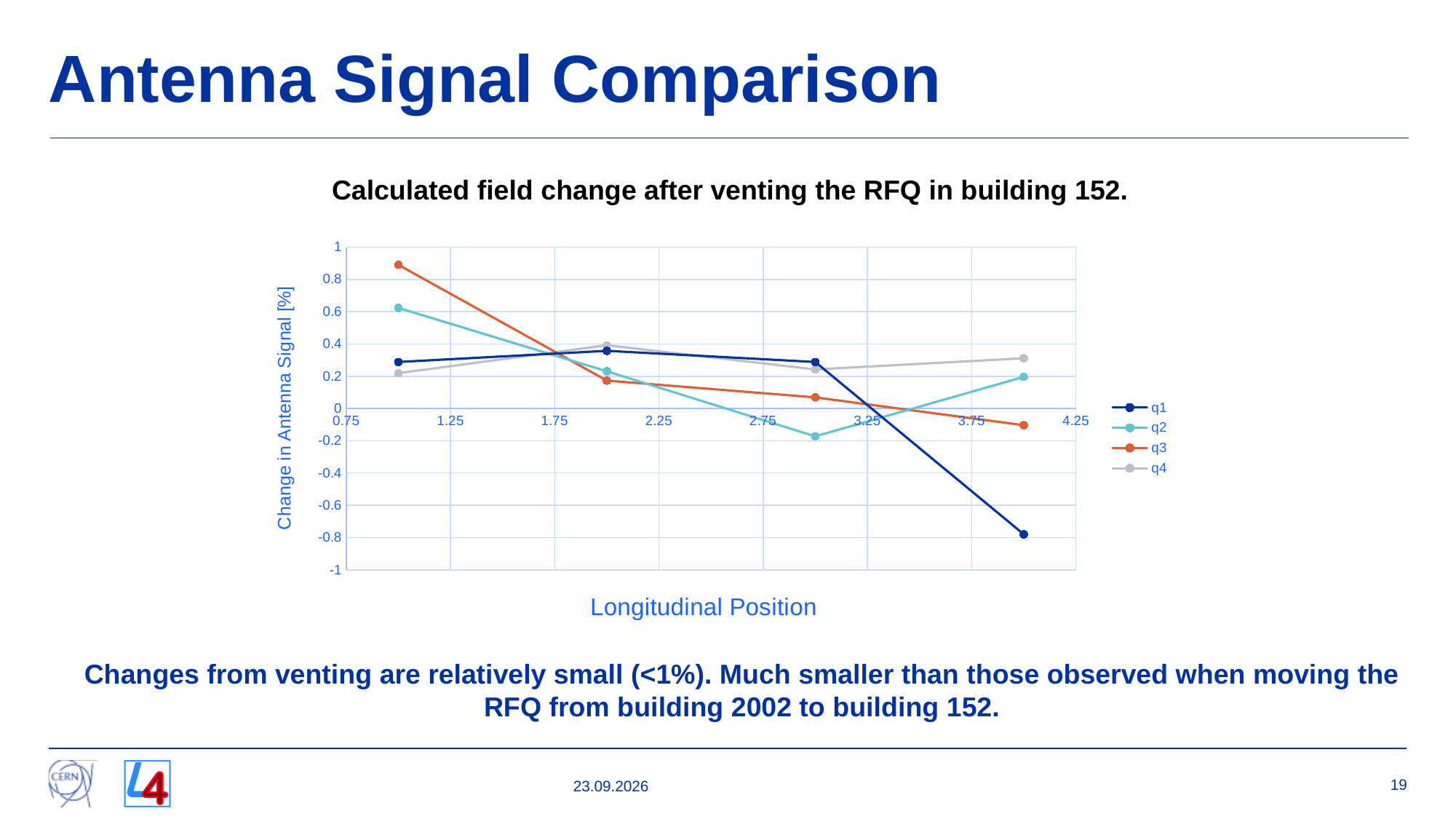
Is the value for q2 at the third longitudinal position (around 3) greater or less than 0? less How many series does the legend list? 4 How many data points does the q1 series have? 4 At the first longitudinal position (around 1), which series has the larger value, q3 or q1? q3 Is the value for q1 at the last longitudinal position (around 4) greater or less than -0.6? less What kind of chart is shown on the slide? line chart What is the label of the y axis? Change in Antenna Signal [%] Which series has the highest value at the first longitudinal position (around 1)? q3 Is the value for q3 at the first longitudinal position (around 1) greater or less than 0.8? greater Does the q3 series rise or fall as the longitudinal position increases? fall Which series has the lowest value at the last longitudinal position (around 4)? q1